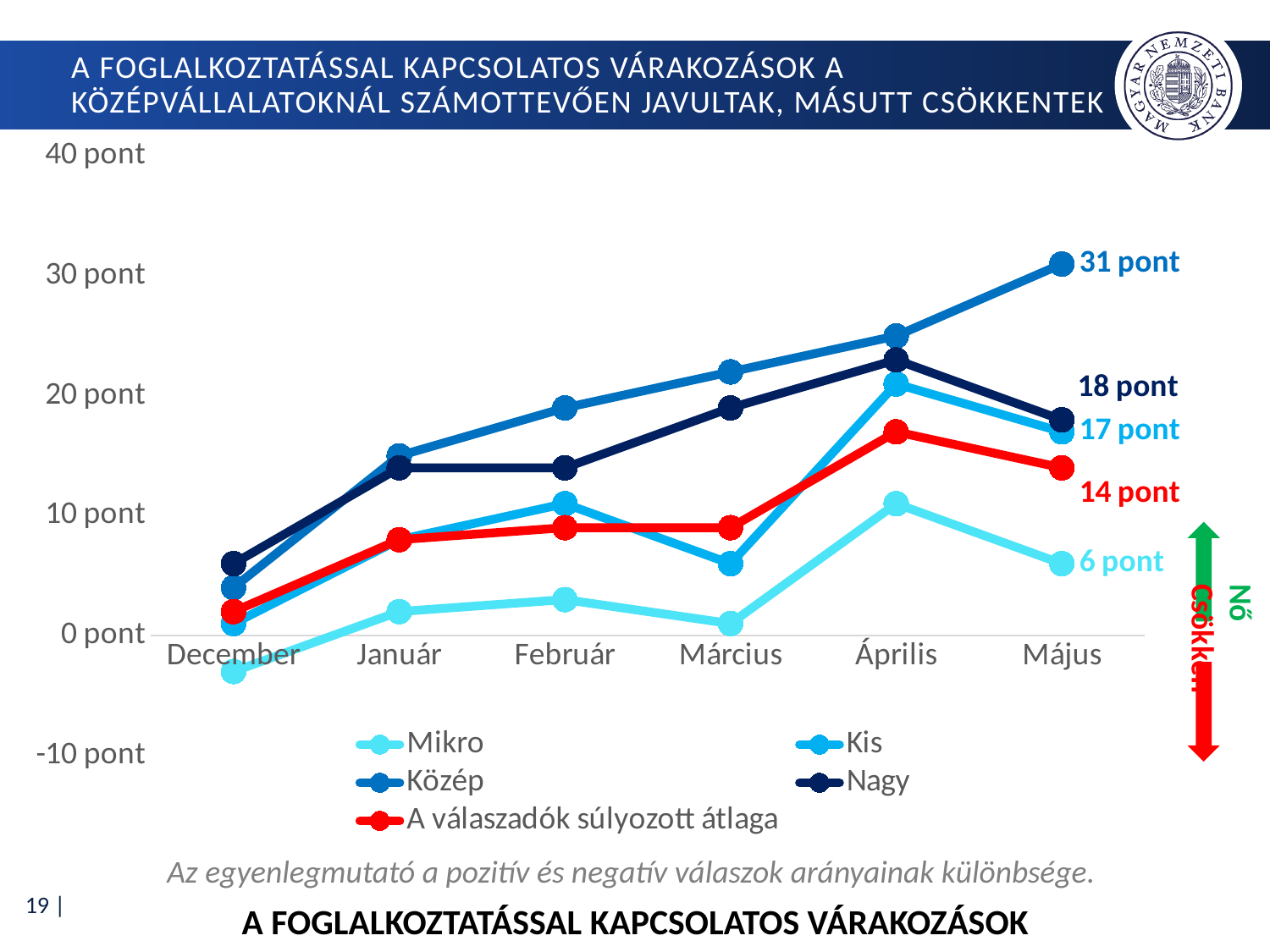
What kind of chart is shown on the slide? line chart What is the difference between the Közép and Mikro values in Május? 25 pont What is the value for Közép in Május? 31 pont Which series has the lowest value in Május? Mikro How many series does the legend list? 5 What is the value for Kis in Május? 17 pont Is the value for Mikro in December greater or less than 0 pont? less Is the value for Közép in Április greater or less than 20 pont? greater What is the value for Mikro in Május? 6 pont What is the value for A válaszadók súlyozott átlaga in Május? 14 pont Which series has the highest value in Május? Közép What is the value for Nagy in Május? 18 pont